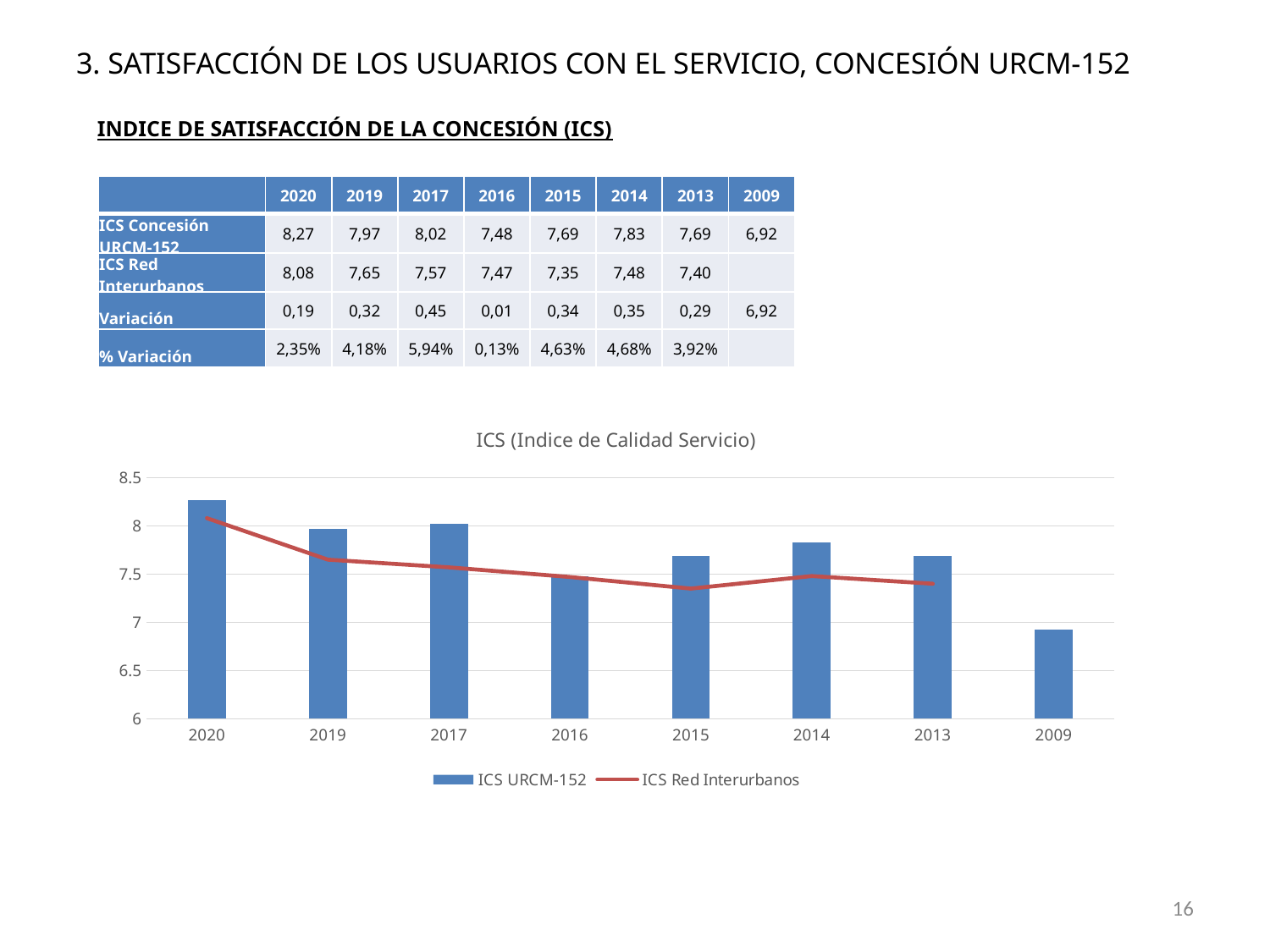
In the ICS chart, which is larger: the ICS URCM-152 bar for 2020 or for 2016? 2020 In the ICS chart, which year has the highest ICS URCM-152 bar? 2020 In the ICS chart, which series is drawn as a red line? ICS Red Interurbanos In the ICS chart, which year has the lowest ICS URCM-152 bar? 2009 Do the ICS URCM-152 bars generally rise or fall moving from 2020 to 2009 along the x axis? fall How many year categories are shown on the x axis of the ICS chart? 8 In the ICS chart, is the ICS URCM-152 bar for 2009 greater or less than 7? less What type of chart is shown under the title 'ICS (Indice de Calidad Servicio)'? A bar chart combined with a line In the ICS chart, is the ICS Red Interurbanos value for 2015 greater or less than 7.5? less According to the table on the slide, what is the ICS Concesión URCM-152 value for 2020? 8,27 In the ICS chart, is the ICS URCM-152 bar for 2020 greater or less than 8? greater How many series does the legend of the ICS chart list? 2